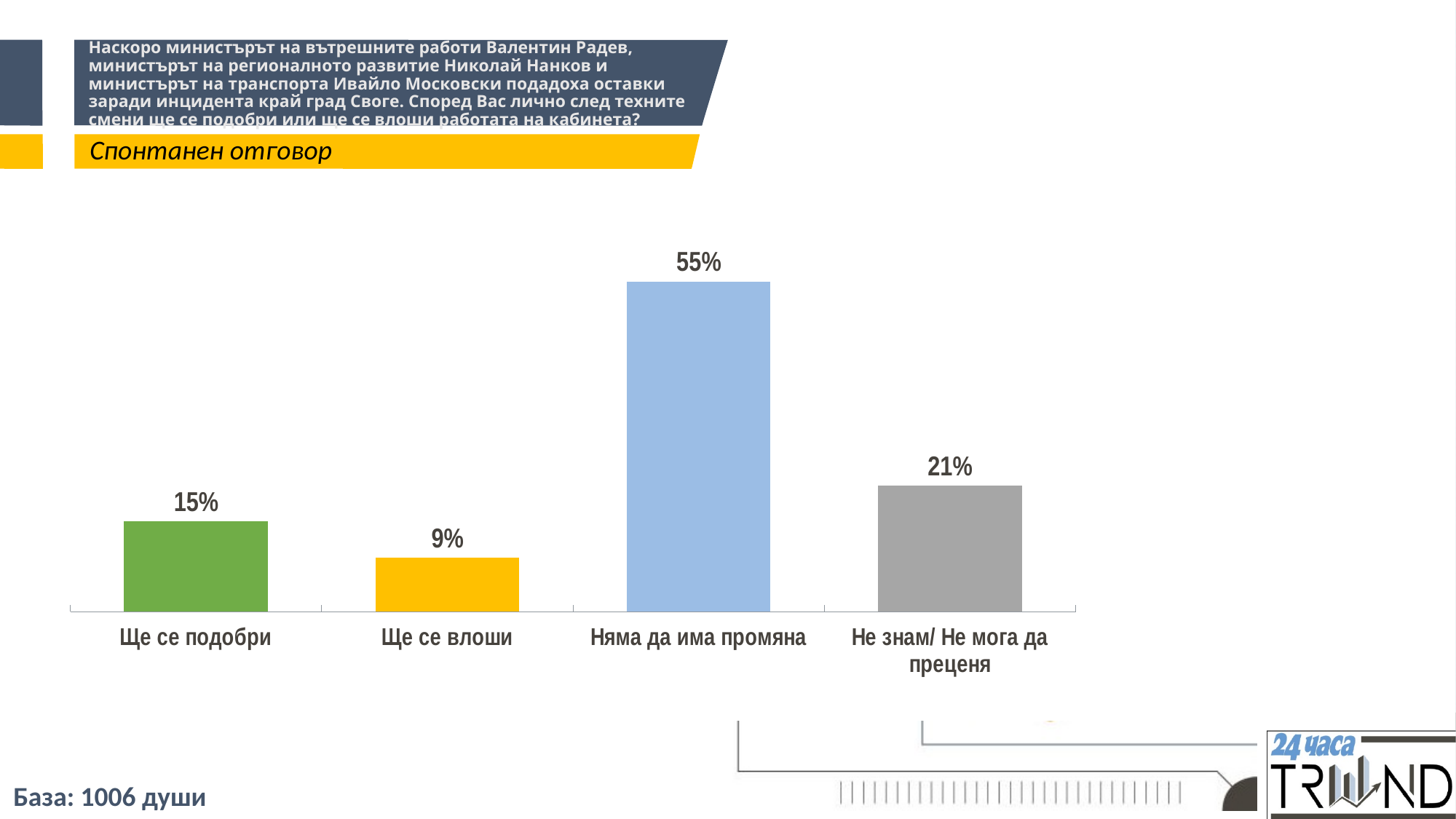
Which is larger, the value for "Ще се подобри" or the value for "Не знам/ Не мога да преценя"? Не знам/ Не мога да преценя What is the difference between the values for "Ще се подобри" and "Ще се влоши"? 6% What is the value for "Ще се влоши"? 9% How many categories are shown in the chart? 4 Which category has the highest value? Няма да има промяна What is the base (sample size) stated on the slide? 1006 души What is the value for "Не знам/ Не мога да преценя"? 21% What kind of chart is shown on the slide? Bar chart What is the value for "Ще се подобри"? 15% What is the value for "Няма да има промяна"? 55% Which category has the lowest value? Ще се влоши What is the difference between the values for "Няма да има промяна" and "Не знам/ Не мога да преценя"? 34%